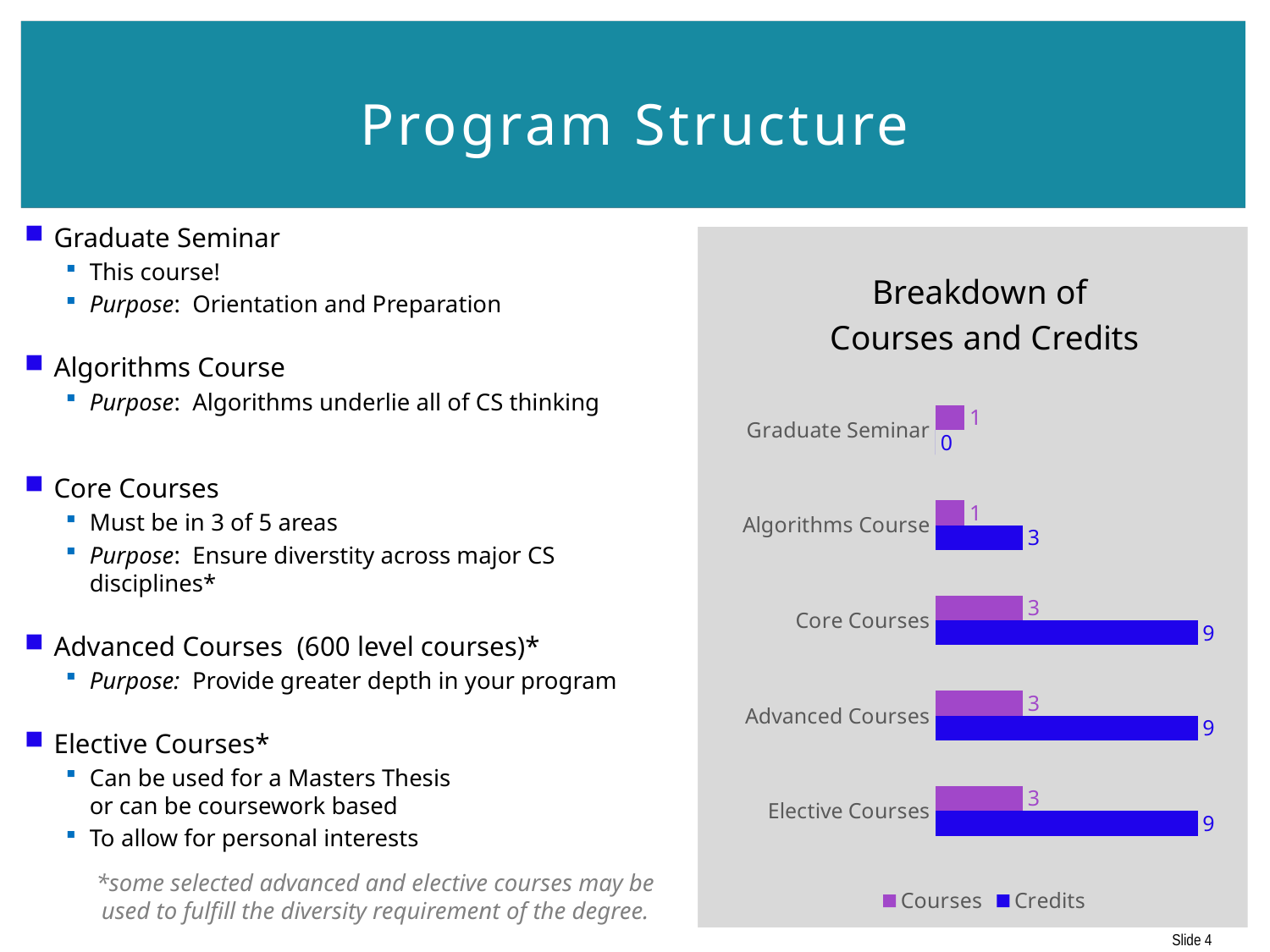
What is the Credits value for Graduate Seminar? 0 What is the Courses value for Algorithms Course? 1 What is the difference between the Credits value for Core Courses and the Credits value for Algorithms Course? 6 Which is larger for Algorithms Course, the Credits value or the Courses value? Credits Which category has the lowest Credits value? Graduate Seminar What is the difference between the Credits value and the Courses value for Advanced Courses? 6 What is the title of the chart? Breakdown of Courses and Credits How many series does the chart legend list? 2 How many categories are shown in the chart? 5 What kind of chart is shown on the slide? bar chart What is the Courses value for Elective Courses? 3 What is the Credits value for Core Courses? 9